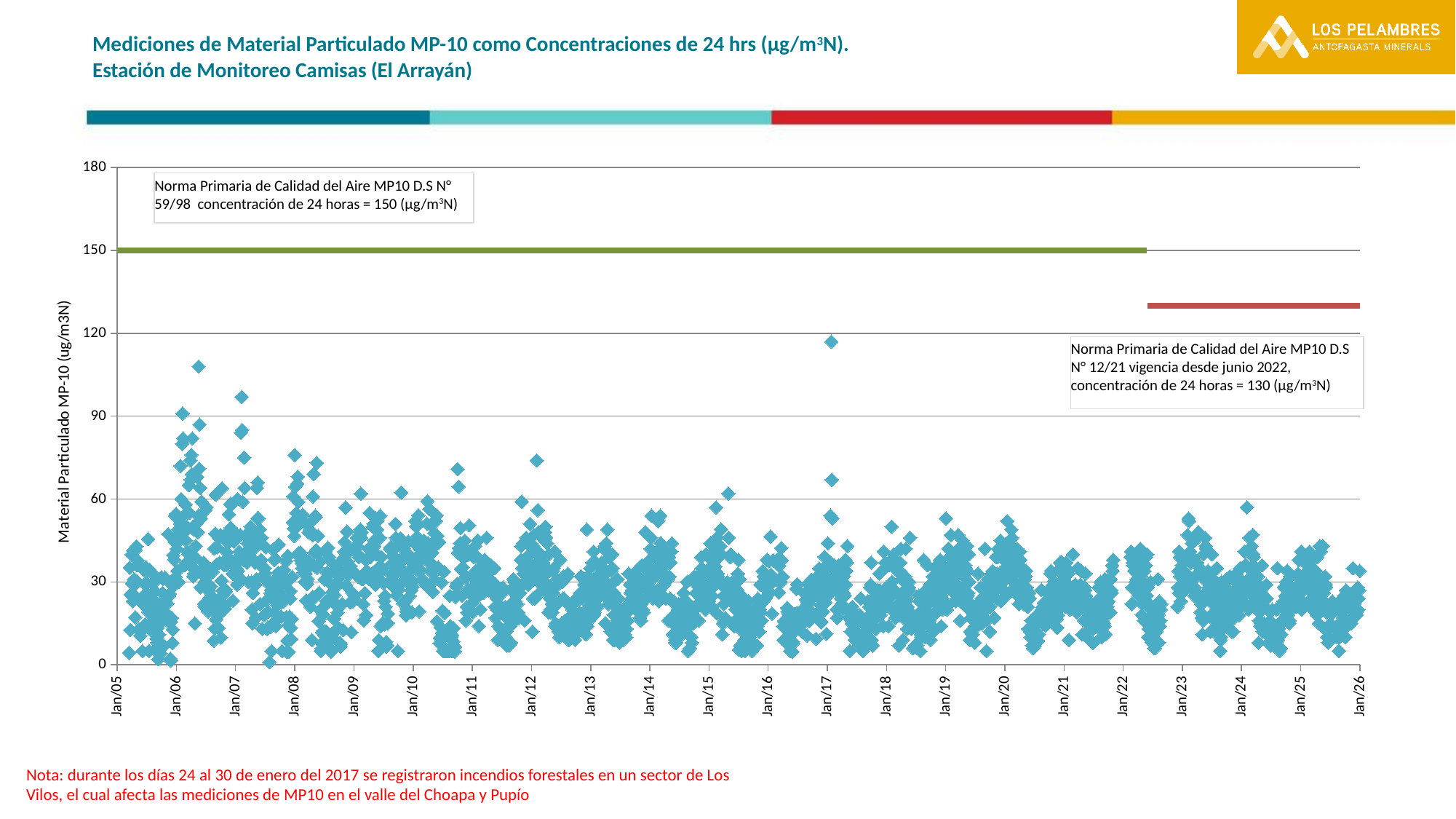
Which reference line is higher, the green one (D.S N° 59/98) or the red one (D.S N° 12/21)? the green one (D.S N° 59/98) Around which x-axis date does the single highest measurement occur? Jan/17 Which monitoring station does the chart title say the measurements come from? Estación de Monitoreo Camisas (El Arrayán) What is the 24-hour concentration limit set by the green reference line (Norma Primaria D.S N° 59/98)? 150 (µg/m³N) How many date ticks are labelled on the x axis, from Jan/05 to Jan/26? 22 What kind of chart is shown on the slide? scatter chart Is the highest measurement near Jan/06 greater or less than 120? less What is the 24-hour concentration limit set by the red reference line (Norma Primaria D.S N° 12/21)? 130 (µg/m³N) Is the highest measurement near Jan/17 greater or less than 90? greater What is the difference between the two reference limits, 150 and 130 µg/m³N? 20 Do the peak measurement values generally rise or fall from Jan/05 to Jan/26? fall Do any measurements exceed the 150 µg/m³N reference line? No